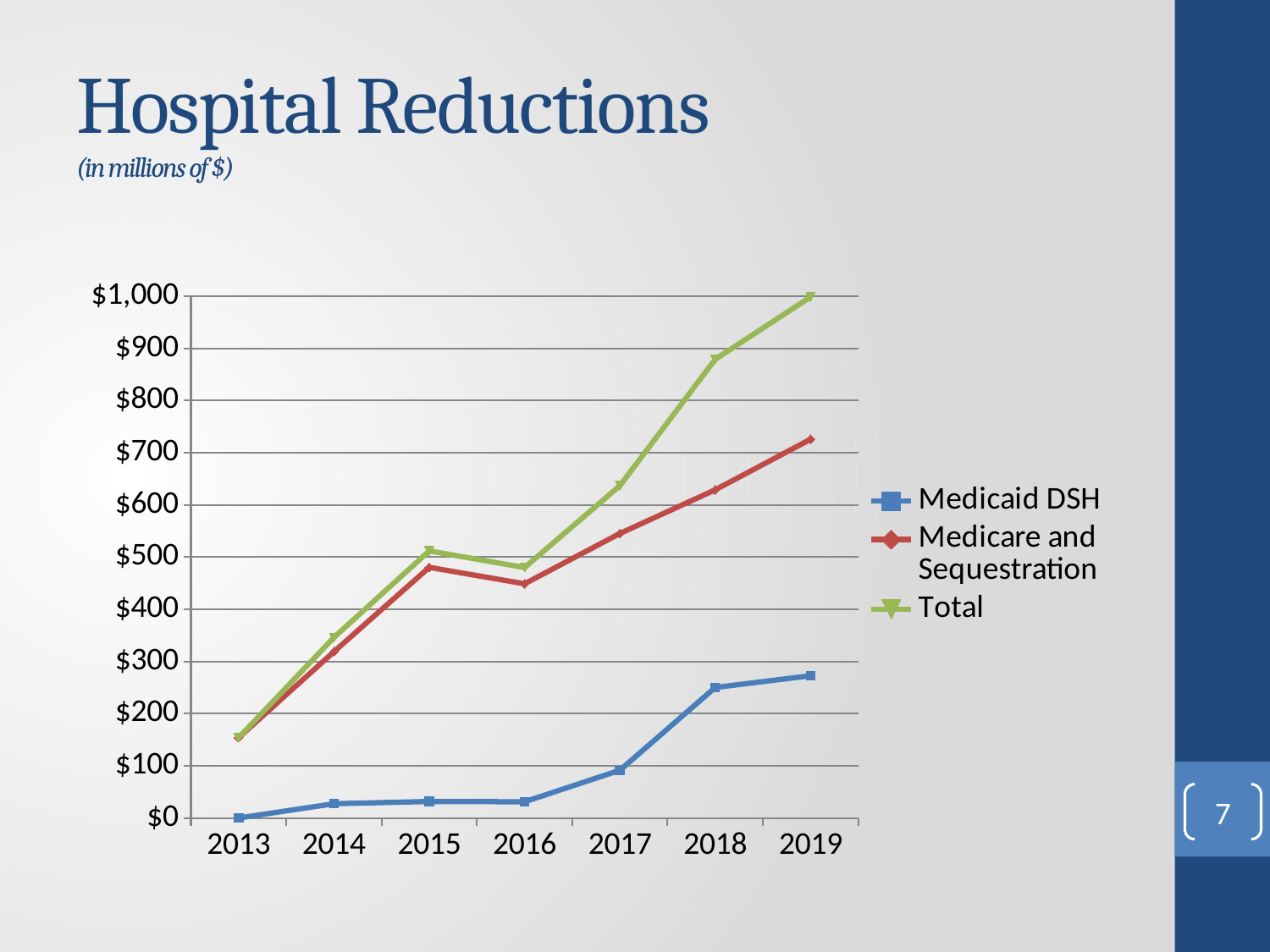
Is the value for Medicaid DSH in 2018 greater or less than $200? greater Is the value for Medicare and Sequestration in 2016 greater or less than $500? less Does the Medicaid DSH series generally rise or fall from 2013 to 2019? rise How many series does the legend list? 3 In 2017, which series has the larger value: Total or Medicaid DSH? Total What kind of chart is shown on the slide? line chart In which year is the Medicaid DSH series at its lowest value? 2013 What is the title of the chart on the slide? Hospital Reductions Is the value for Medicare and Sequestration in 2019 greater or less than $700? greater How many years are plotted along the x axis? 7 In which year does the Total series reach its highest value? 2019